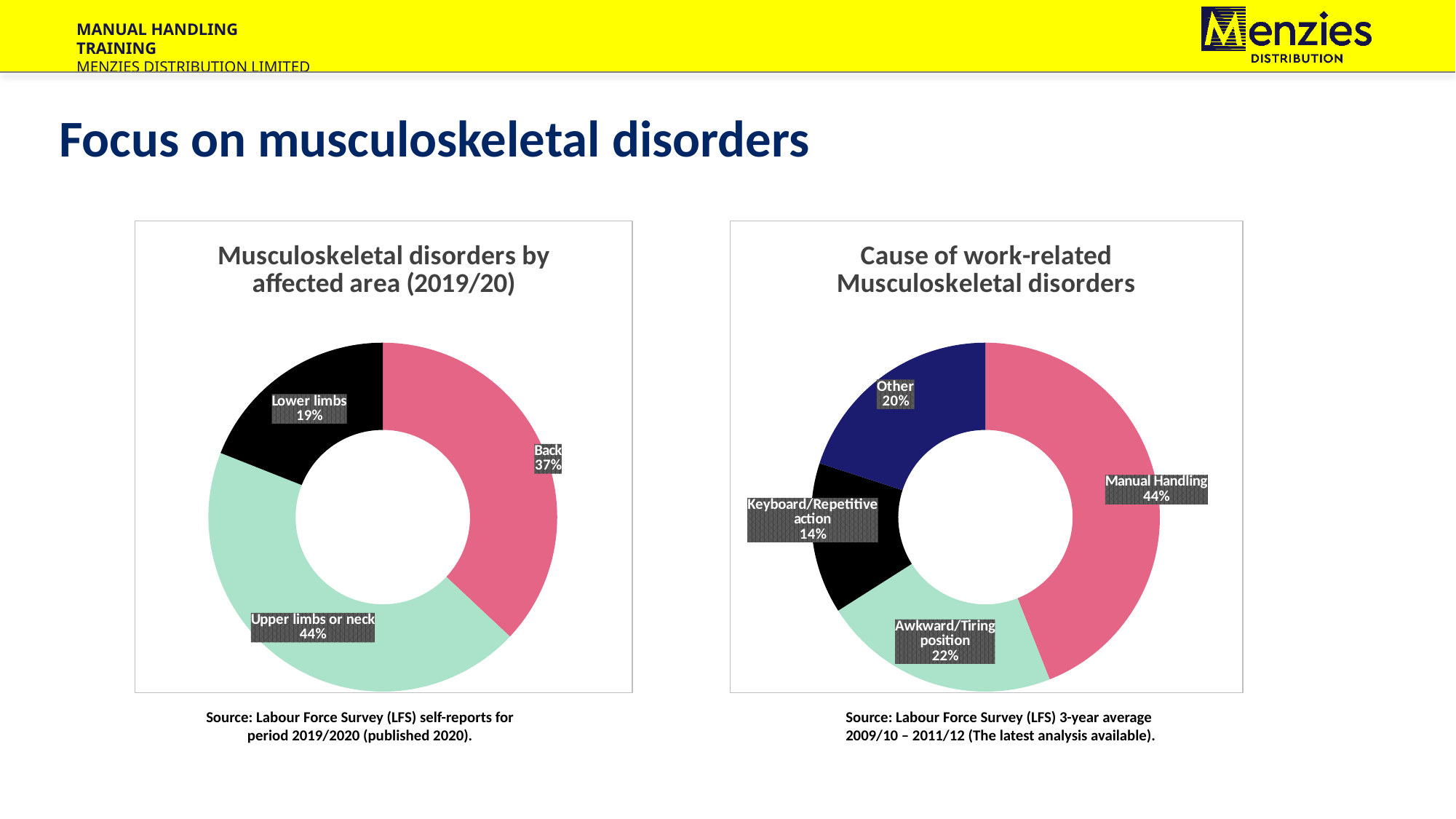
In the 'Cause of work-related Musculoskeletal disorders' chart, what share is labelled for Keyboard/Repetitive action? 14% In the 'Musculoskeletal disorders by affected area (2019/20)' chart, what share is labelled for Back? 37% In the 'Cause of work-related Musculoskeletal disorders' chart, how many causes are shown? 4 In the 'Musculoskeletal disorders by affected area (2019/20)' chart, which affected area has the smallest share? Lower limbs In the 'Musculoskeletal disorders by affected area (2019/20)' chart, how many slices are there? 3 In the 'Musculoskeletal disorders by affected area (2019/20)' chart, what is the difference in percentage points between Upper limbs or neck and Back? 7 In the 'Musculoskeletal disorders by affected area (2019/20)' chart, which affected area has the largest share? Upper limbs or neck In the 'Musculoskeletal disorders by affected area (2019/20)' chart, what share is labelled for Lower limbs? 19% In the 'Cause of work-related Musculoskeletal disorders' chart, what share is labelled for Manual Handling? 44% In the 'Cause of work-related Musculoskeletal disorders' chart, which cause has the smallest share? Keyboard/Repetitive action In the 'Cause of work-related Musculoskeletal disorders' chart, which is larger, Awkward/Tiring position or Other? Awkward/Tiring position What kind of chart is the 'Cause of work-related Musculoskeletal disorders' chart? Doughnut (pie) chart